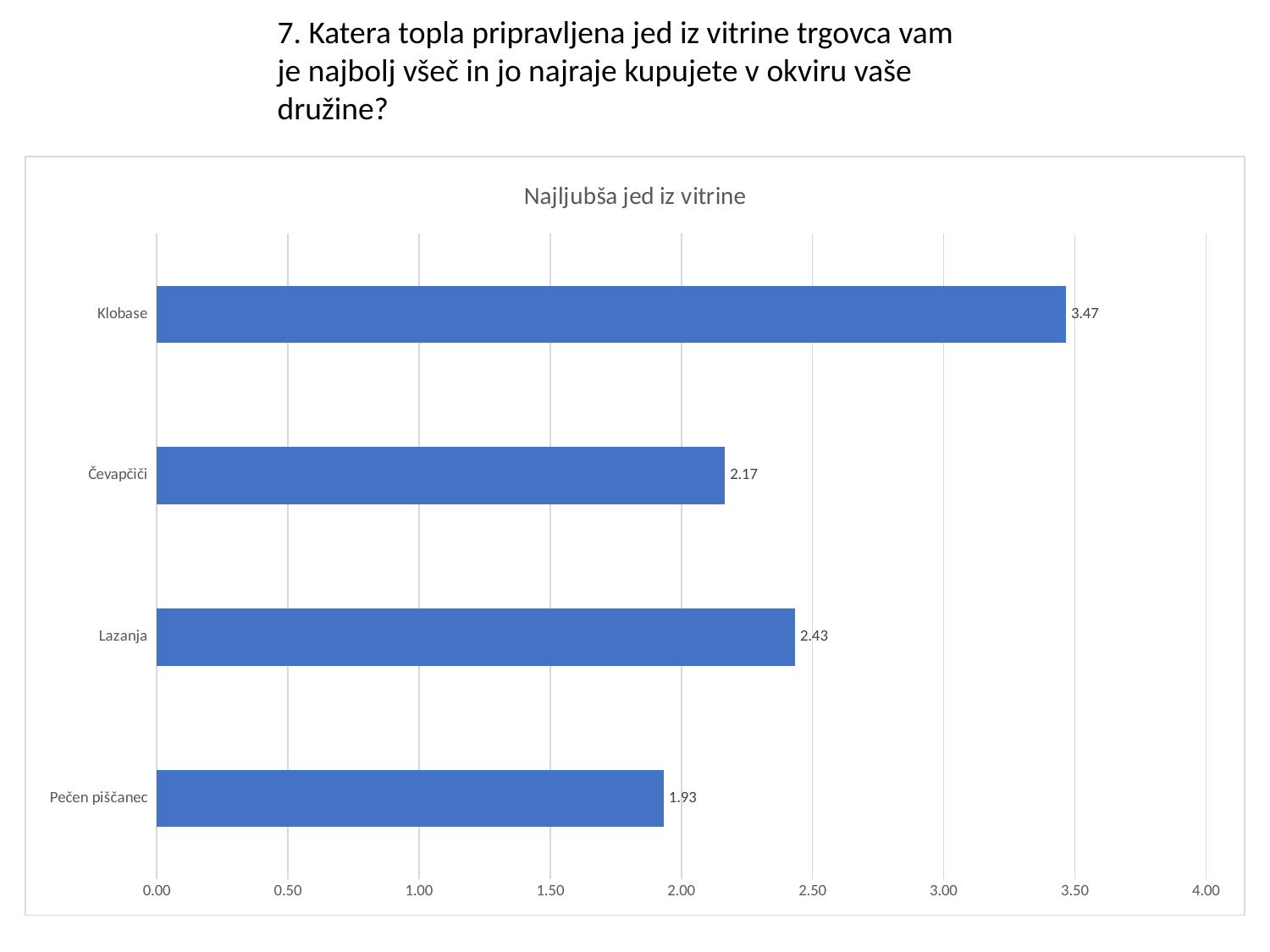
What is the value for Lazanja? 2.43 Which category has the highest value? Klobase How many categories are shown in the chart? 4 What is the value for Čevapčiči? 2.17 Which is larger, the value for Lazanja or the value for Čevapčiči? Lazanja Is the value for Pečen piščanec greater or less than 2.00? less Which category has the lowest value? Pečen piščanec What is the value for Klobase? 3.47 What is the value for Pečen piščanec? 1.93 What kind of chart is shown on the slide? Bar chart What is the difference between the values for Klobase and Pečen piščanec? 1.54 What is the difference between the values for Lazanja and Čevapčiči? 0.26